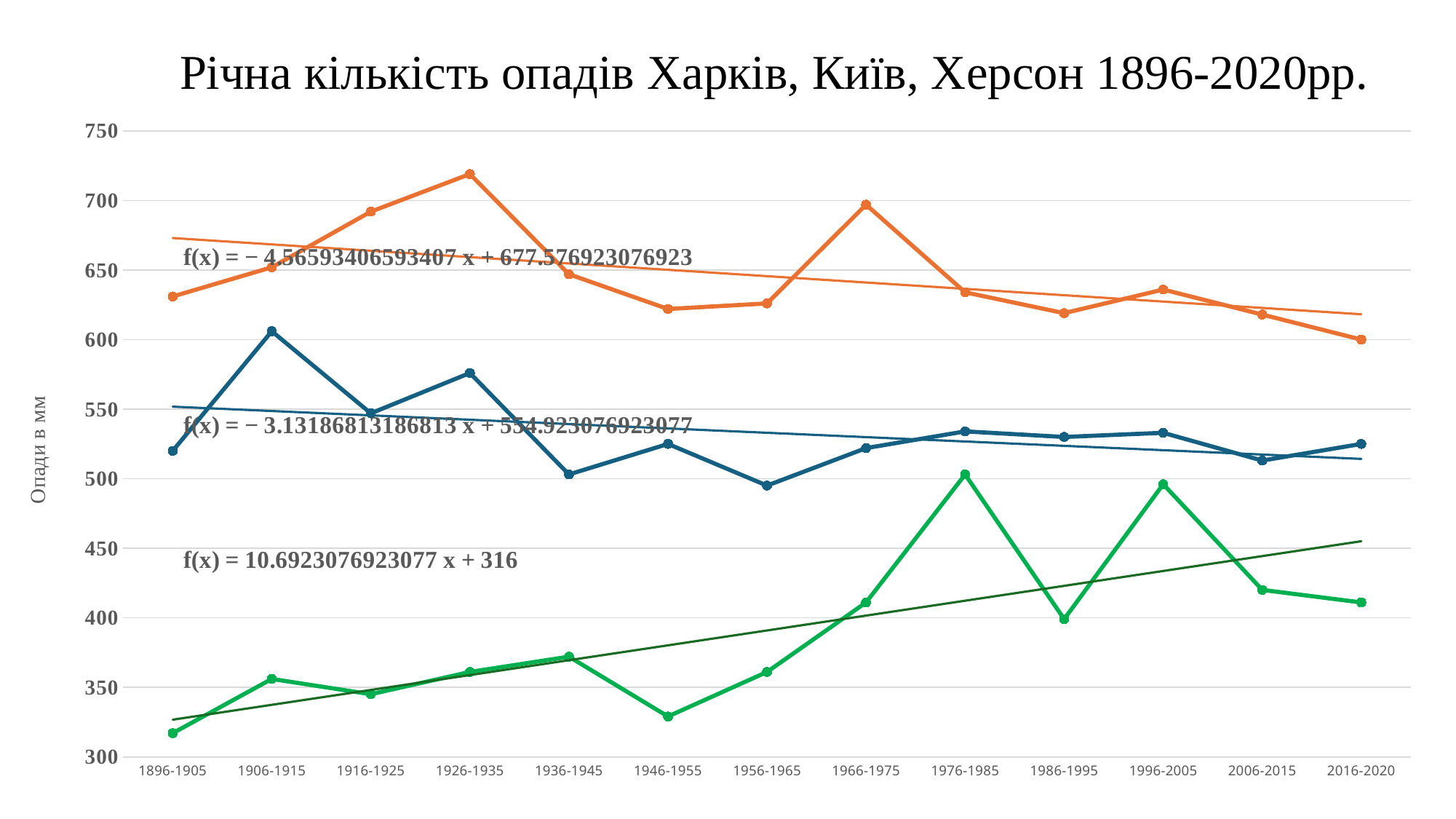
Does the green series generally rise or fall from 1896-1905 to 2016-2020? rise What is the title of the chart? Річна кількість опадів Харків, Київ, Херсон 1896-2020рр. How many time periods are shown along the x axis? 13 In which period does the blue series reach its highest value? 1906-1915 Is the value of the orange series for 2016-2020 greater or less than 650? less For 1896-1905, which is larger: the orange series or the blue series? orange series In which period does the green series have its lowest value? 1896-1905 What kind of chart is shown on the slide? line chart Is the value of the green series for 1976-1985 greater or less than 450? greater In which period does the orange series reach its highest value? 1926-1935 Is the value of the blue series for 1936-1945 greater or less than 550? less What is the label of the vertical axis? Опади в мм